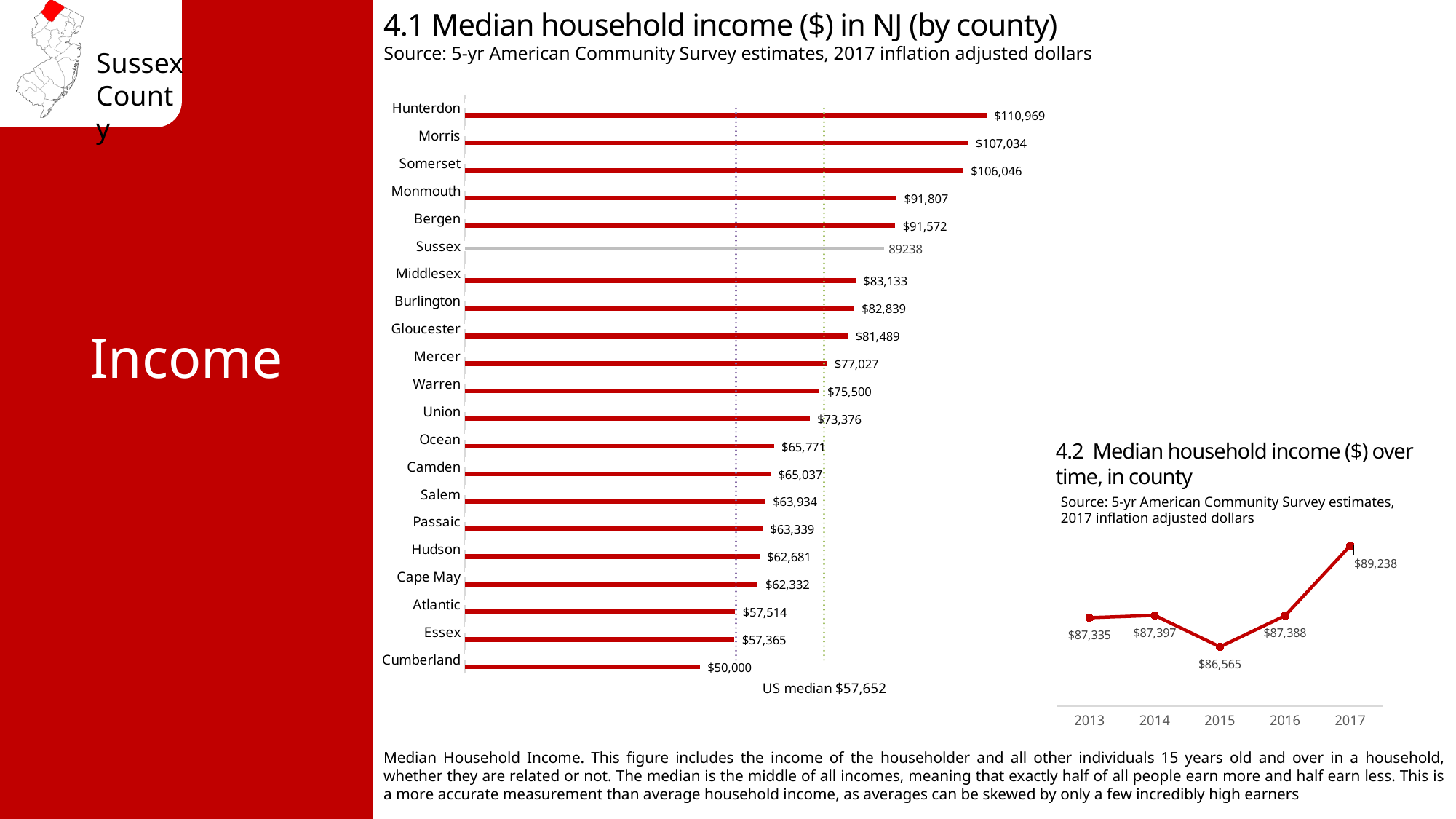
In chart 4.1, which county has the highest median household income? Hunterdon In chart 4.1, how many counties are shown? 21 In chart 4.1, which county has a higher median household income, Monmouth or Bergen? Monmouth In chart 4.1, what is the median household income for Sussex? 89238 In chart 4.2, what is the difference between the median household income in 2017 and 2015? $2,673 In chart 4.2, what was the median household income in 2015? $86,565 In chart 4.1, which county has the lowest median household income? Cumberland In chart 4.1, what is the median household income for Hunterdon? $110,969 What kind of chart is chart 4.2? Line chart In chart 4.1, what is the difference between the median household income of Hunterdon and Cumberland? $60,969 In chart 4.2, which year had the highest median household income? 2017 What kind of chart is chart 4.1? Bar chart